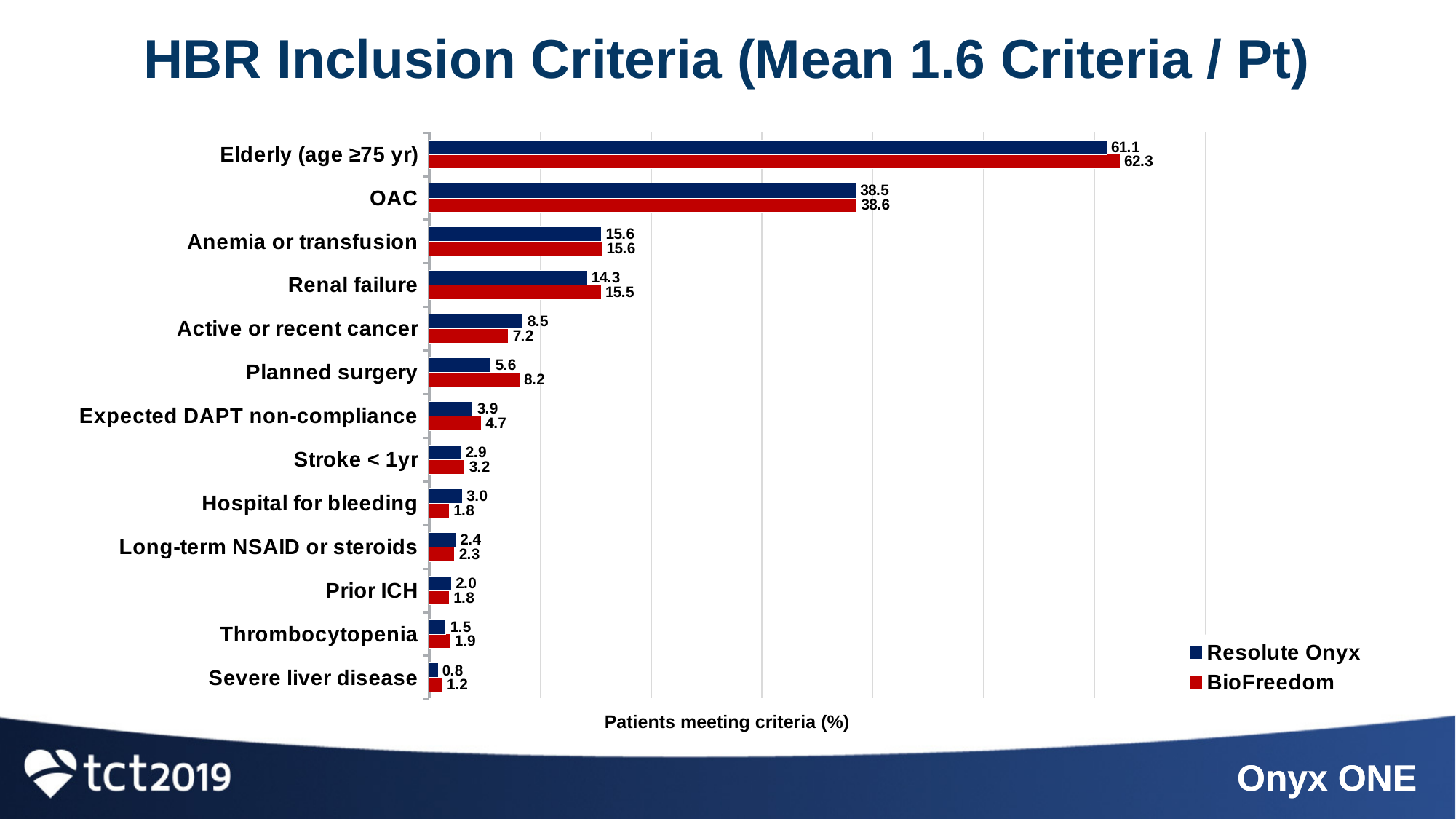
What is the Resolute Onyx value for Elderly (age ≥75 yr)? 61.1 What is the Resolute Onyx value for Renal failure? 14.3 For Active or recent cancer, which series has the larger value, Resolute Onyx or BioFreedom? Resolute Onyx Which category has the highest BioFreedom value? Elderly (age ≥75 yr) What kind of chart is shown on the slide? Bar chart What is the difference between the BioFreedom and Resolute Onyx values for Planned surgery? 2.6 What is the BioFreedom value for Planned surgery? 8.2 What is the difference between the Resolute Onyx and BioFreedom values for Hospital for bleeding? 1.2 How many categories are shown on the chart? 13 Which category has the lowest Resolute Onyx value? Severe liver disease How many series does the legend list? 2 What is the label of the horizontal axis? Patients meeting criteria (%)